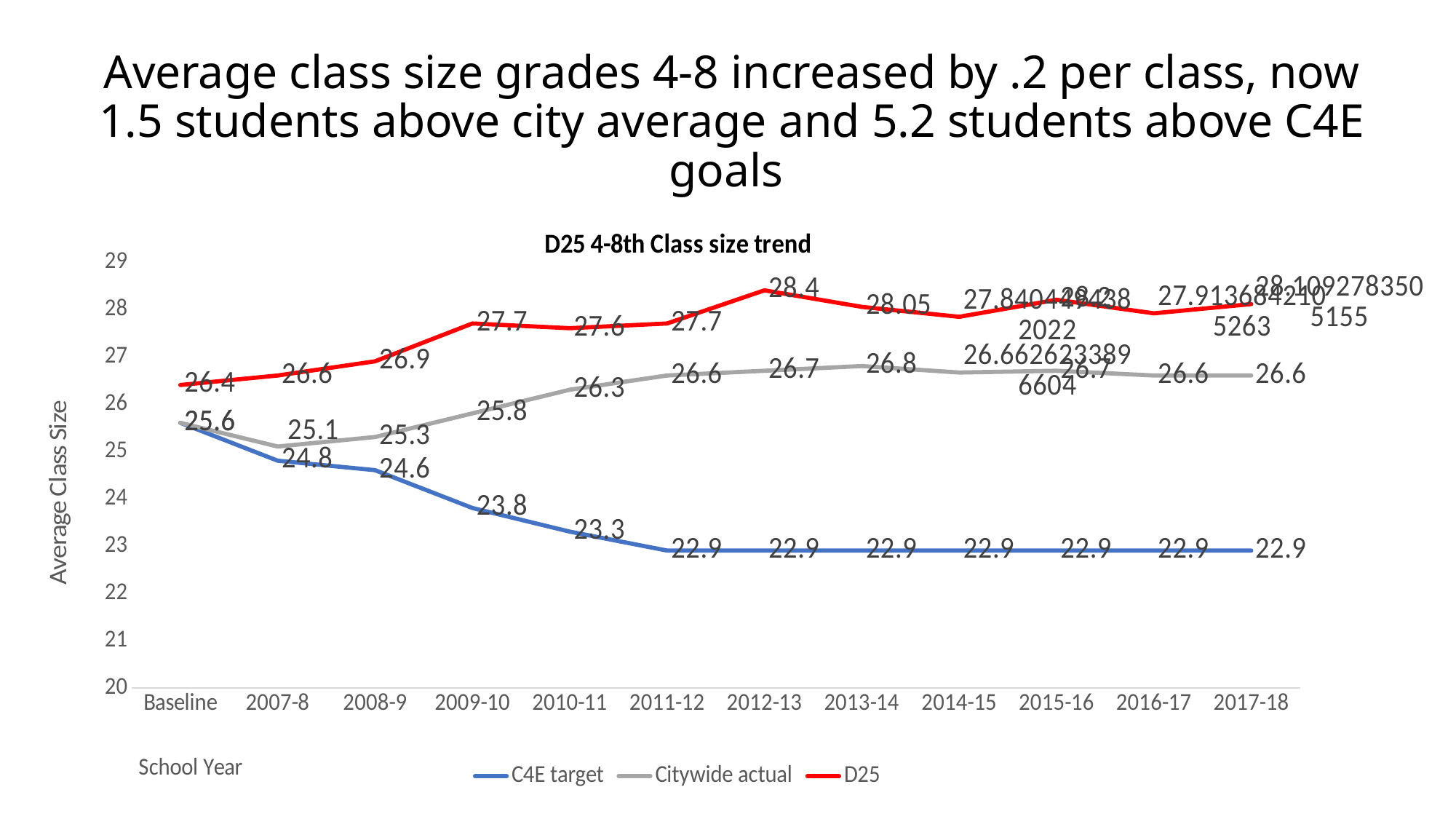
Does the C4E target line rise or fall from Baseline to 2011-12? falls What is the C4E target value for 2017-18? 22.9 Which colour is used for the D25 line? red How many series does the legend of the 'D25 4-8th Class size trend' chart list? 3 In which school year is the Citywide actual value lowest? 2007-8 In 2009-10, which is larger: the D25 value or the Citywide actual value? D25 In 2012-13, how much higher is the D25 value than the Citywide actual value? 1.7 What is the D25 average class size in 2012-13? 28.4 What is the Citywide actual value in 2007-8? 25.1 How many school-year points are plotted along the x axis? 12 In which school year does the D25 line reach its highest value? 2012-13 What type of chart is shown on the slide? line chart